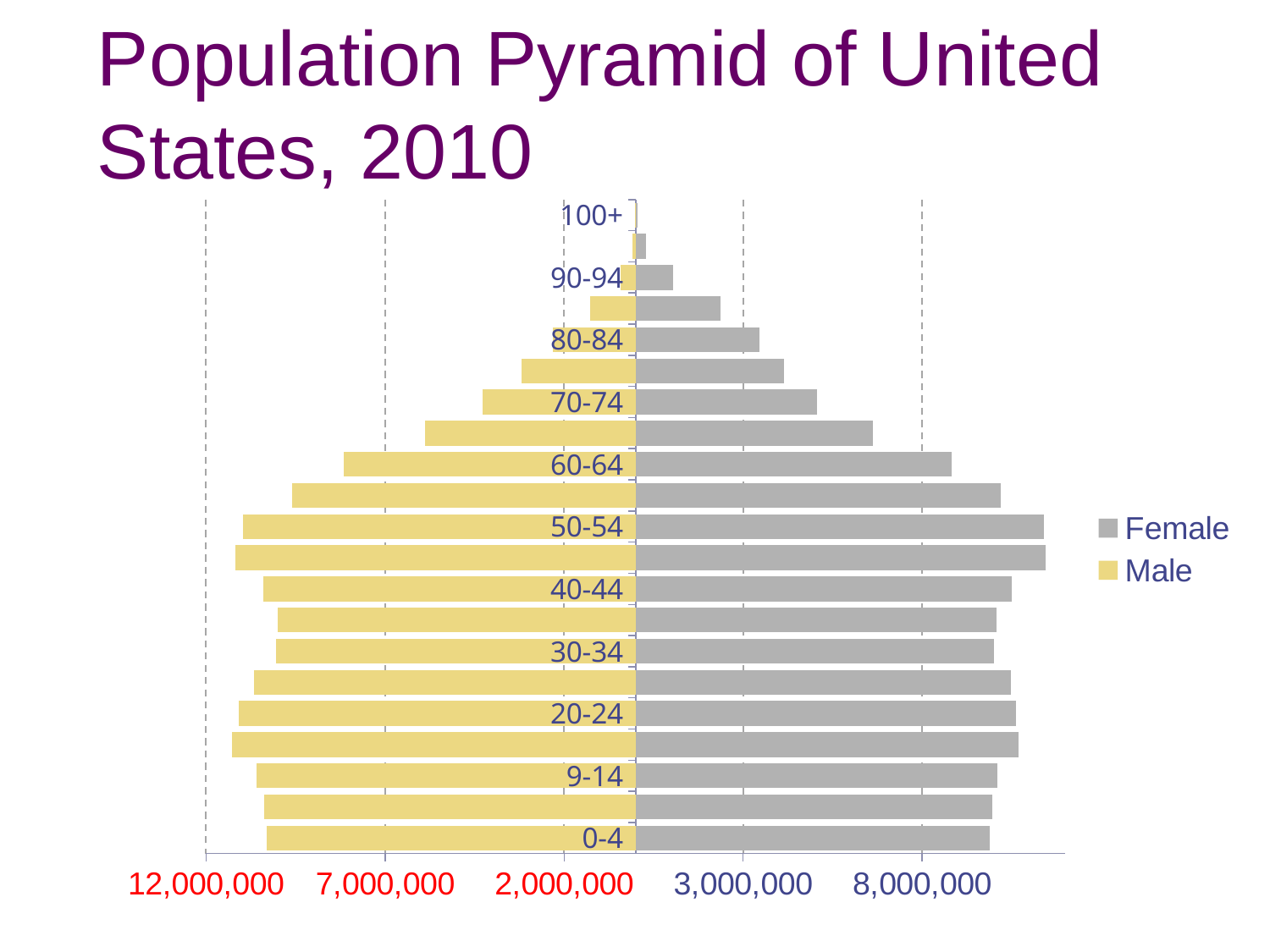
Is the Female value for the 90-94 age group greater or less than 3,000,000? less Which series is shown in yellow? Male Which series is shown in gray? Female Which is larger: the Female value for 50-54 or the Female value for 90-94? 50-54 How many series does the legend list? 2 Is the Female value for the 50-54 age group greater or less than 8,000,000? greater How many age groups (bars per series) are plotted? 21 Moving from the 50-54 age group up to 100+, do the Female bars get longer or shorter? shorter Is the Male value for the 0-4 age group greater or less than 7,000,000? greater Which age group has the smallest Male value? 100+ What kind of chart is shown on the slide? bar chart Which age group has the smallest Female value? 100+